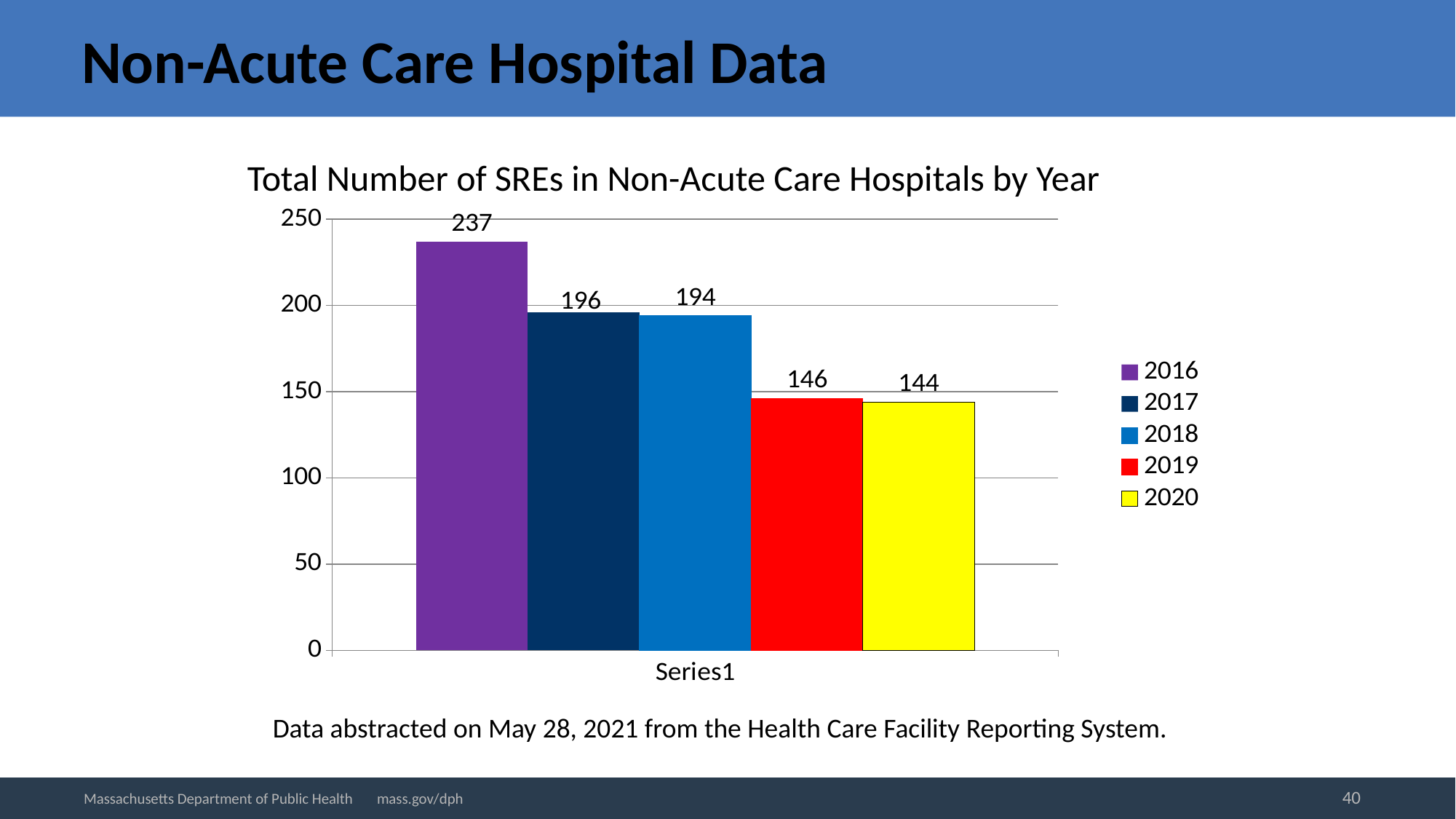
What is the total number of SREs in non-acute care hospitals for 2020? 144 How many years are shown in the legend? 5 What kind of chart is shown on the slide? bar chart Which year had more SREs, 2017 or 2020? 2017 What is the difference between the number of SREs in 2016 and 2017? 41 Which year has the lowest total number of SREs? 2020 Do the SRE totals rise or fall from 2016 to 2020? fall What is the total number of SREs in non-acute care hospitals for 2019? 146 What is the difference between the number of SREs in 2018 and 2019? 48 Which year has the highest total number of SREs? 2016 What is the total number of SREs in non-acute care hospitals for 2016? 237 Is the value for 2018 greater or less than 150? greater